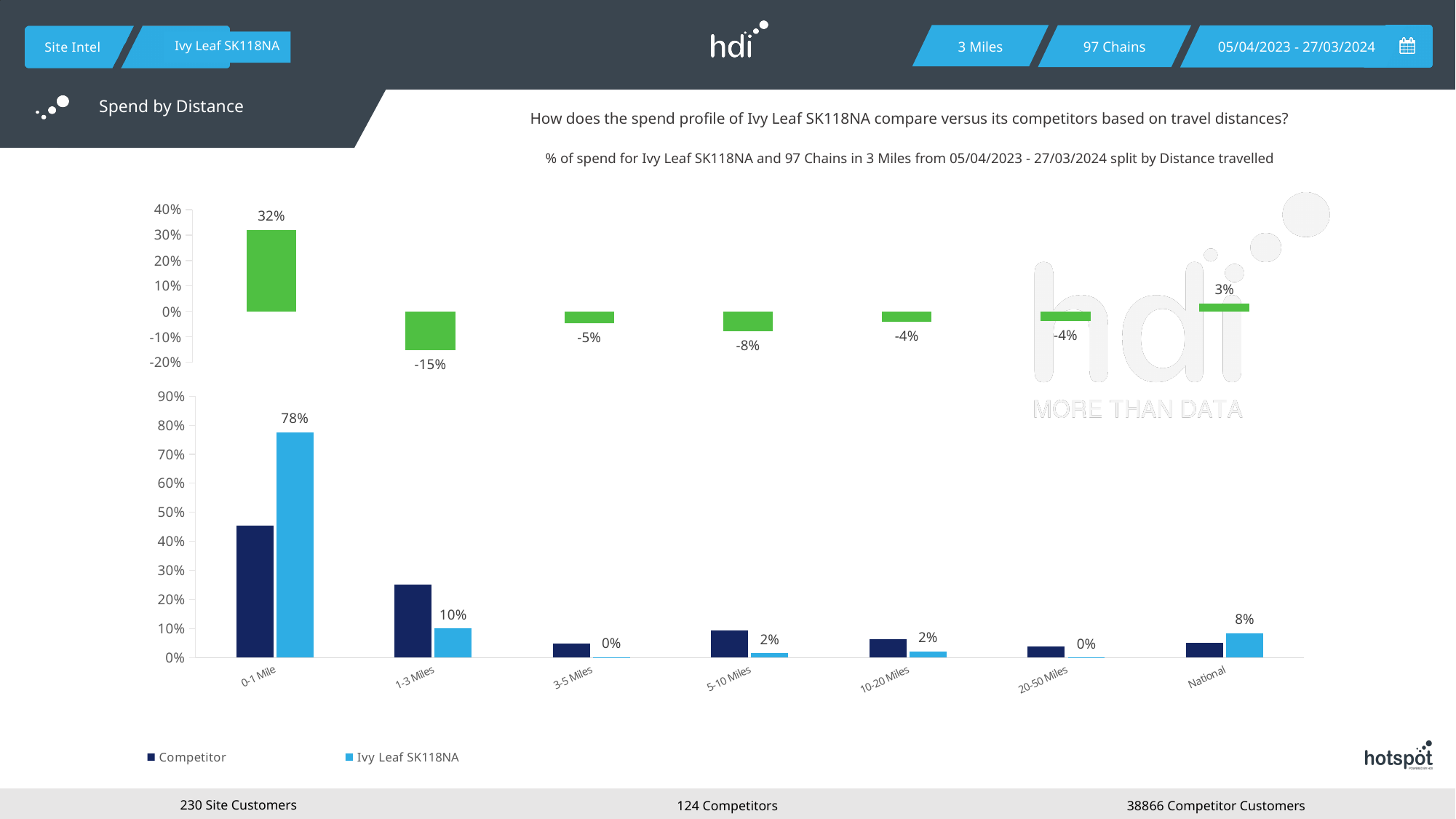
In the bottom chart, what is the value for Ivy Leaf SK118NA at National? 8% In the top chart, what is the value for 1-3 Miles? -15% In the bottom chart, what is the difference between the Ivy Leaf SK118NA values at 0-1 Mile and 1-3 Miles? 68% In the top chart, which distance band has the lowest value? 1-3 Miles How many distance categories are shown on the x axis of the bottom chart? 7 In the top chart, which distance band has the highest value? 0-1 Mile In the bottom chart, what is the value for Ivy Leaf SK118NA at 0-1 Mile? 78% In the bottom chart, which is larger at 0-1 Mile, Competitor or Ivy Leaf SK118NA? Ivy Leaf SK118NA In the bottom chart, is the Competitor value at 1-3 Miles greater or less than 30%? less How many series does the legend of the bottom chart list? 2 What type of chart is the bottom chart? Bar chart In the bottom chart, is the Competitor value at 0-1 Mile greater or less than 40%? greater